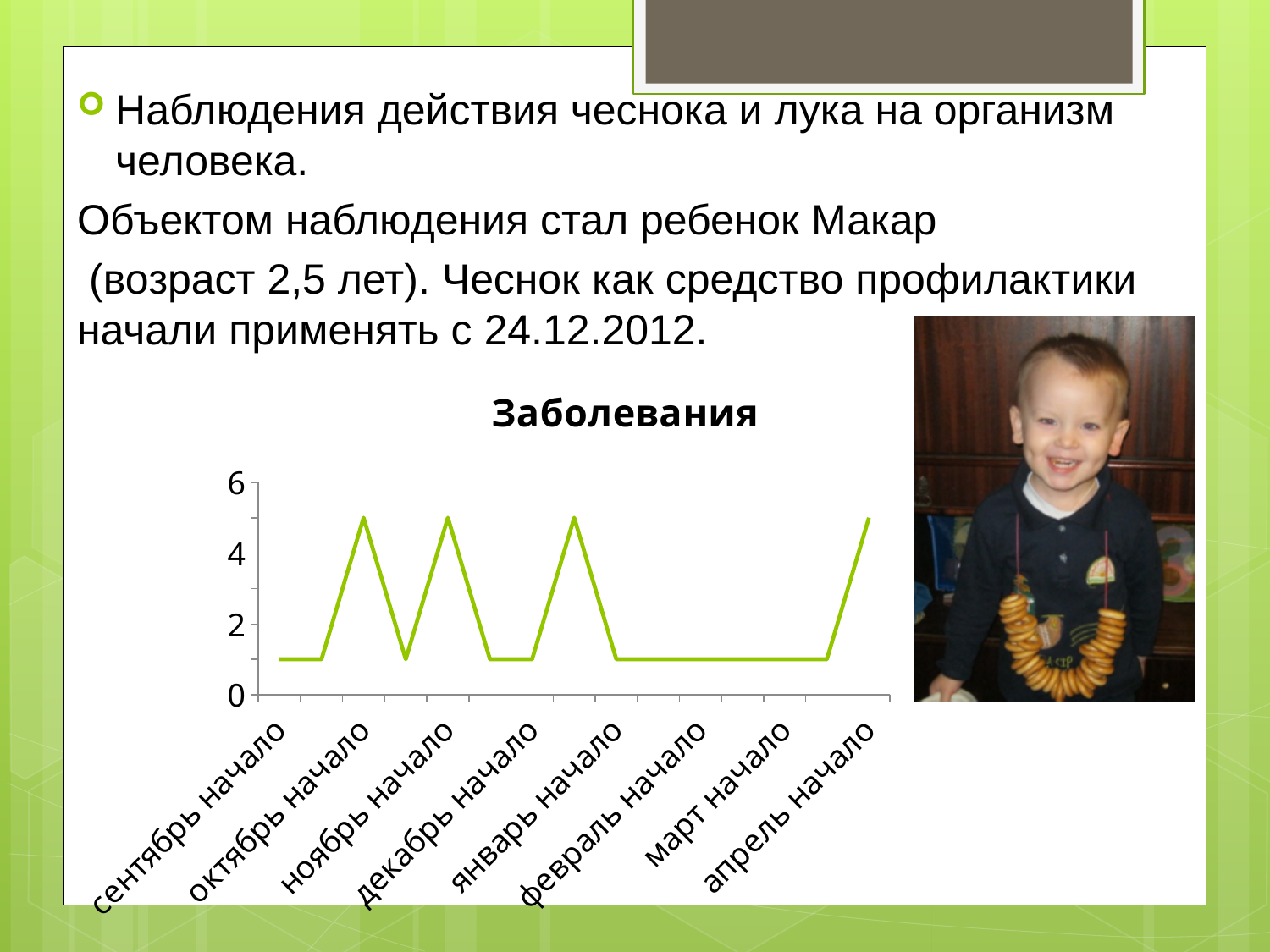
How many category labels are shown on the x axis of the chart? 8 Is the value for ноябрь начало greater or less than 4? greater Which is larger, the value for октябрь начало or the value for декабрь начало? октябрь начало What is the title of the chart? Заболевания Which is larger, the value for февраль начало or the value for апрель начало? апрель начало Is the value for март начало greater or less than 2? less Is the value for январь начало greater or less than 2? less What kind of chart is shown on the slide? line chart Does the line rise or fall between март начало and апрель начало? rise